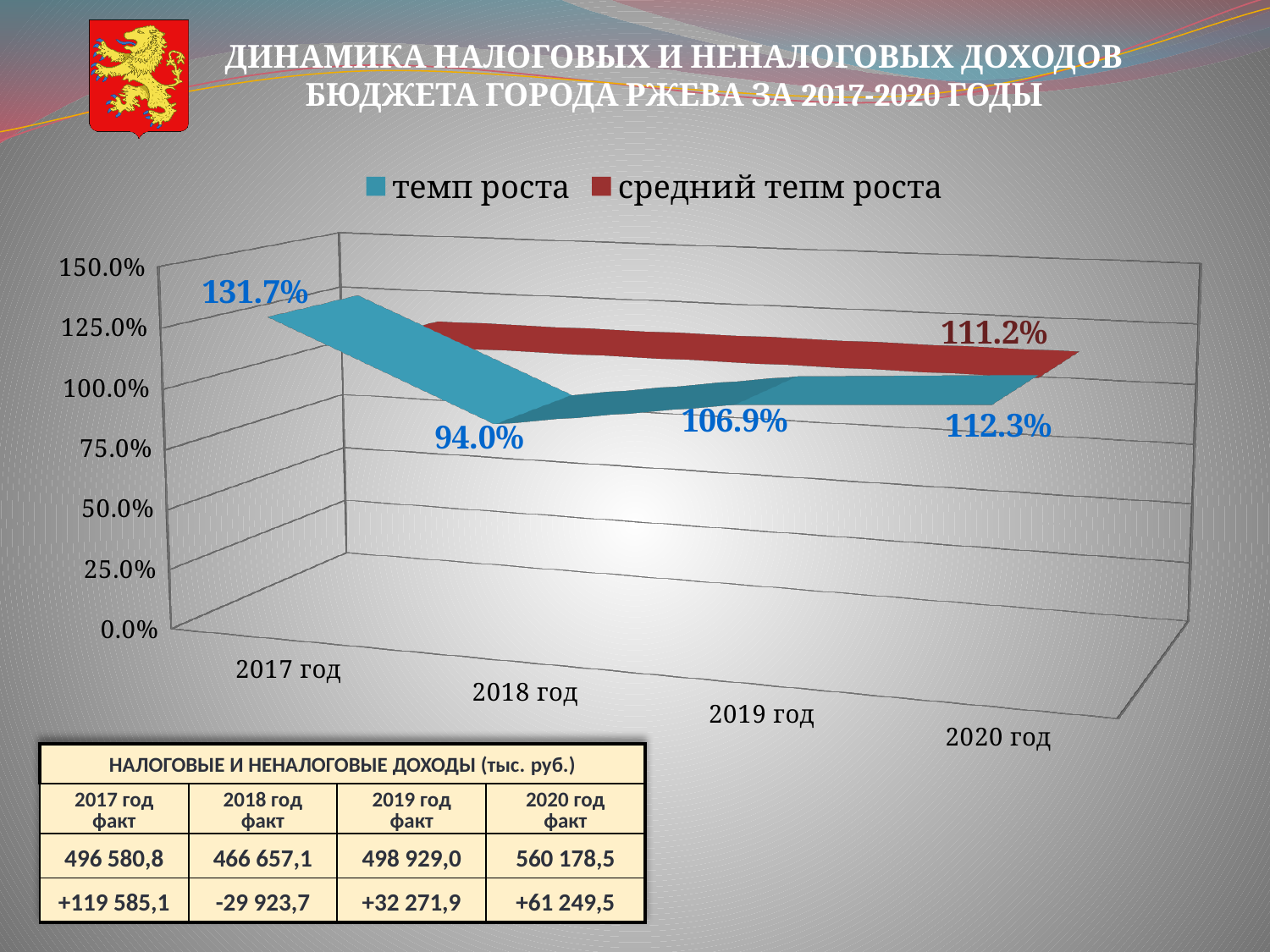
What is the difference between темп роста in 2017 год and 2018 год? 37.7% How many years are shown on the x axis of the chart? 4 What is the value of темп роста for 2019 год? 106.9% What is the value of темп роста for 2018 год? 94.0% In which year is темп роста highest? 2017 год What is the value of темп роста for 2017 год? 131.7% In which year is темп роста lowest? 2018 год What value is labelled for средний тепм роста? 111.2% What is the value of темп роста for 2020 год? 112.3% Which is larger, темп роста in 2019 год or in 2020 год? 2020 год Is the value of темп роста for 2018 год greater or less than 100.0%? less How many series does the chart legend list? 2